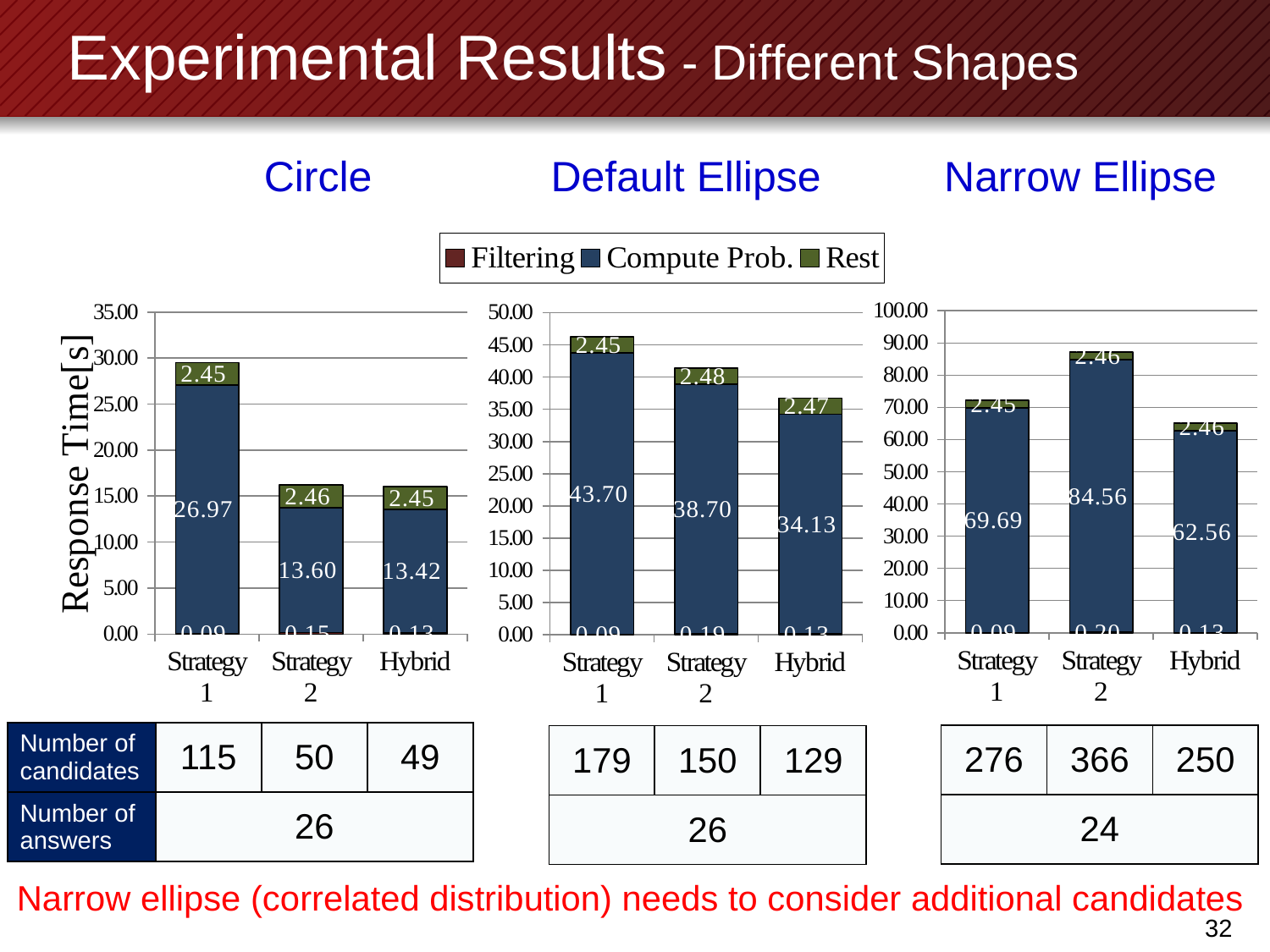
What kind of chart is the Circle chart? Stacked bar chart In the Default Ellipse chart, which category has the lowest Compute Prob. value? Hybrid In the Narrow Ellipse chart, which category has the highest Compute Prob. value? Strategy 2 In the Default Ellipse chart, what is the Compute Prob. value for Hybrid? 34.13 In the Narrow Ellipse chart, which has the larger Compute Prob. value, Strategy 1 or Hybrid? Strategy 1 In the Default Ellipse chart, what is the Rest value for Strategy 2? 2.48 How many series does the shared legend list for the charts? 3 In the Narrow Ellipse chart, is the total height of the Strategy 2 bar greater or less than 80.00? greater In the Default Ellipse chart, do the Compute Prob. values rise or fall from Strategy 1 to Hybrid? Fall In the Circle chart, what is the difference between the Compute Prob. values for Strategy 1 and Strategy 2? 13.37 In the Narrow Ellipse chart, what is the Compute Prob. value for Strategy 2? 84.56 In the Circle chart, what is the Compute Prob. value for Strategy 1? 26.97